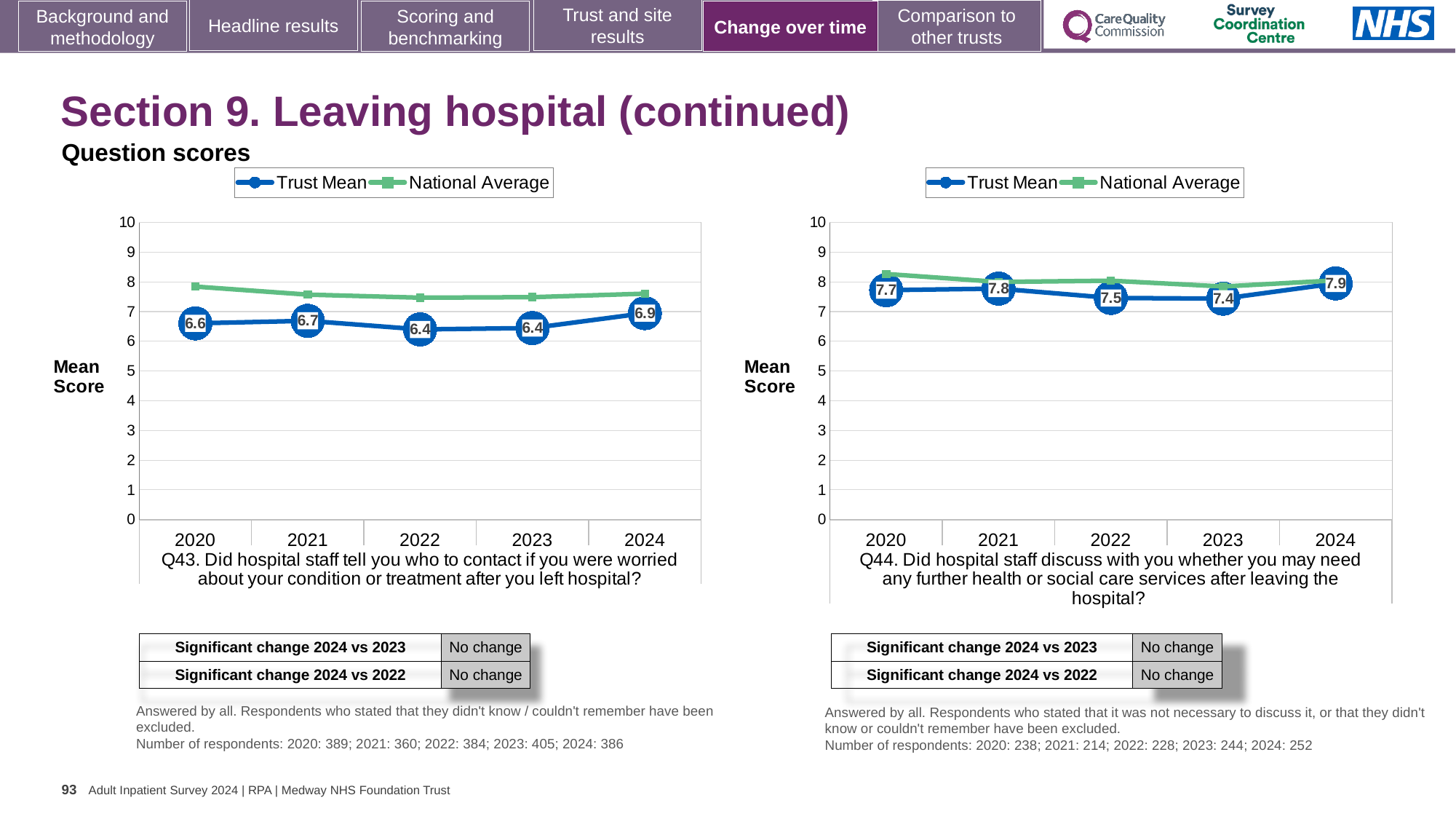
In the Q44 chart on the right, what is the Trust Mean score for 2021? 7.8 In the Q43 chart on the left, what is the difference between the Trust Mean scores for 2024 and 2023? 0.5 In the Q44 chart on the right, which is larger, the Trust Mean for 2024 or the Trust Mean for 2022? 2024 In the Q43 chart on the left, what is the Trust Mean score for 2020? 6.6 In the Q43 chart on the left, which year has the highest Trust Mean score? 2024 In the Q43 chart on the left, is the National Average for 2020 greater or less than 7? greater In the Q43 chart on the left, what is the Trust Mean score for 2024? 6.9 In the Q44 chart on the right, what is the Trust Mean score for 2023? 7.4 How many years are plotted on the x axis of the Q43 chart on the left? 5 In the Q44 chart on the right, how many series does the legend list? 2 In the Q44 chart on the right, which year has the lowest Trust Mean score? 2023 What kind of chart is the Q44 chart on the right? Line chart